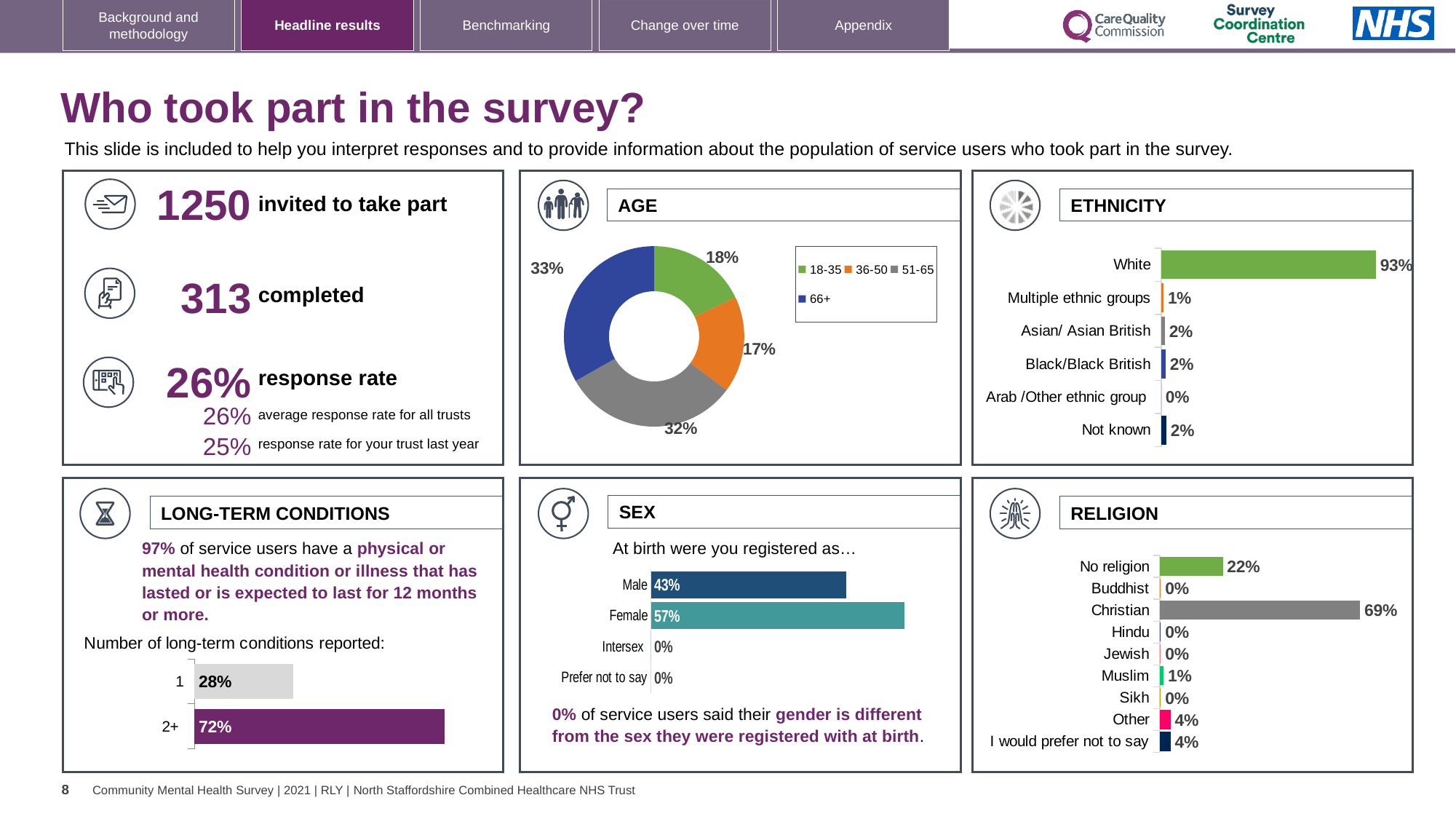
In the ETHNICITY chart, which category has the lowest value? Arab /Other ethnic group In the AGE chart, which age group has the smallest share? 36-50 In the SEX chart, what is the value for Male? 43% What kind of chart is the AGE chart? Doughnut chart In the SEX chart, which is larger, Male or Female? Female In the LONG-TERM CONDITIONS chart, what is the difference between the value for 2+ and the value for 1? 44% How many categories are shown in the ETHNICITY chart? 6 In the ETHNICITY chart, what is the value for White? 93% In the RELIGION chart, what is the value for No religion? 22% How many entries does the legend of the AGE chart list? 4 In the AGE chart, what percentage of respondents are aged 66+? 33% In the RELIGION chart, which category has the highest value? Christian